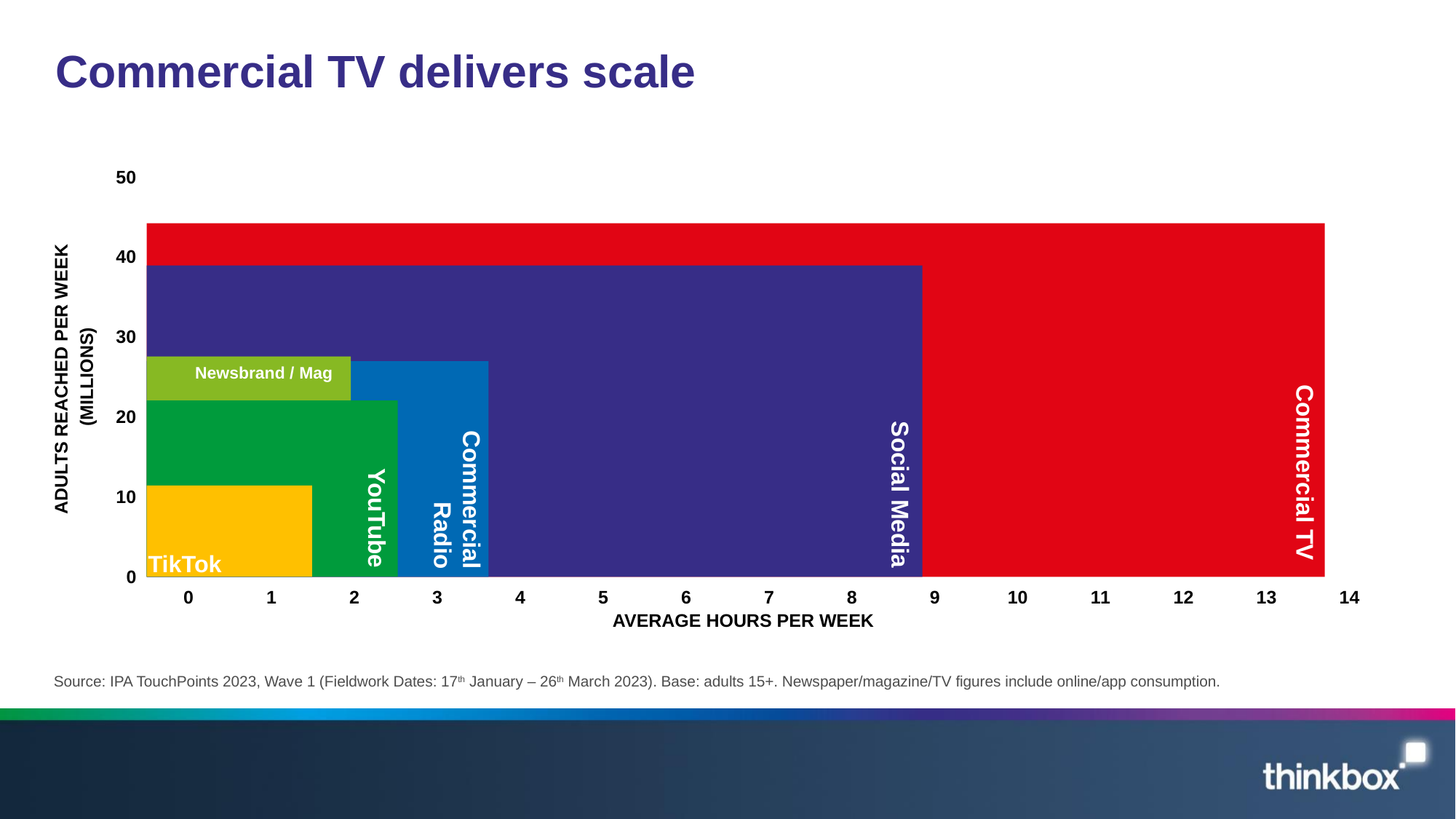
Is the number of adults reached per week by TikTok greater or less than 10 million? greater What is the label of the horizontal axis of the chart? AVERAGE HOURS PER WEEK Which media category has the lowest average hours per week? TikTok Which media category reaches the most adults per week? Commercial TV Is the number of adults reached per week by Commercial Radio greater or less than 30 million? less Is the number of adults reached per week by Commercial TV greater or less than 40 million? greater Which reaches more adults per week, Social Media or Commercial Radio? Social Media Which media category reaches the fewest adults per week? TikTok Which media category has the highest average hours per week? Commercial TV What is the title of the chart on the slide? Commercial TV delivers scale How many media categories are shown in the chart? 6